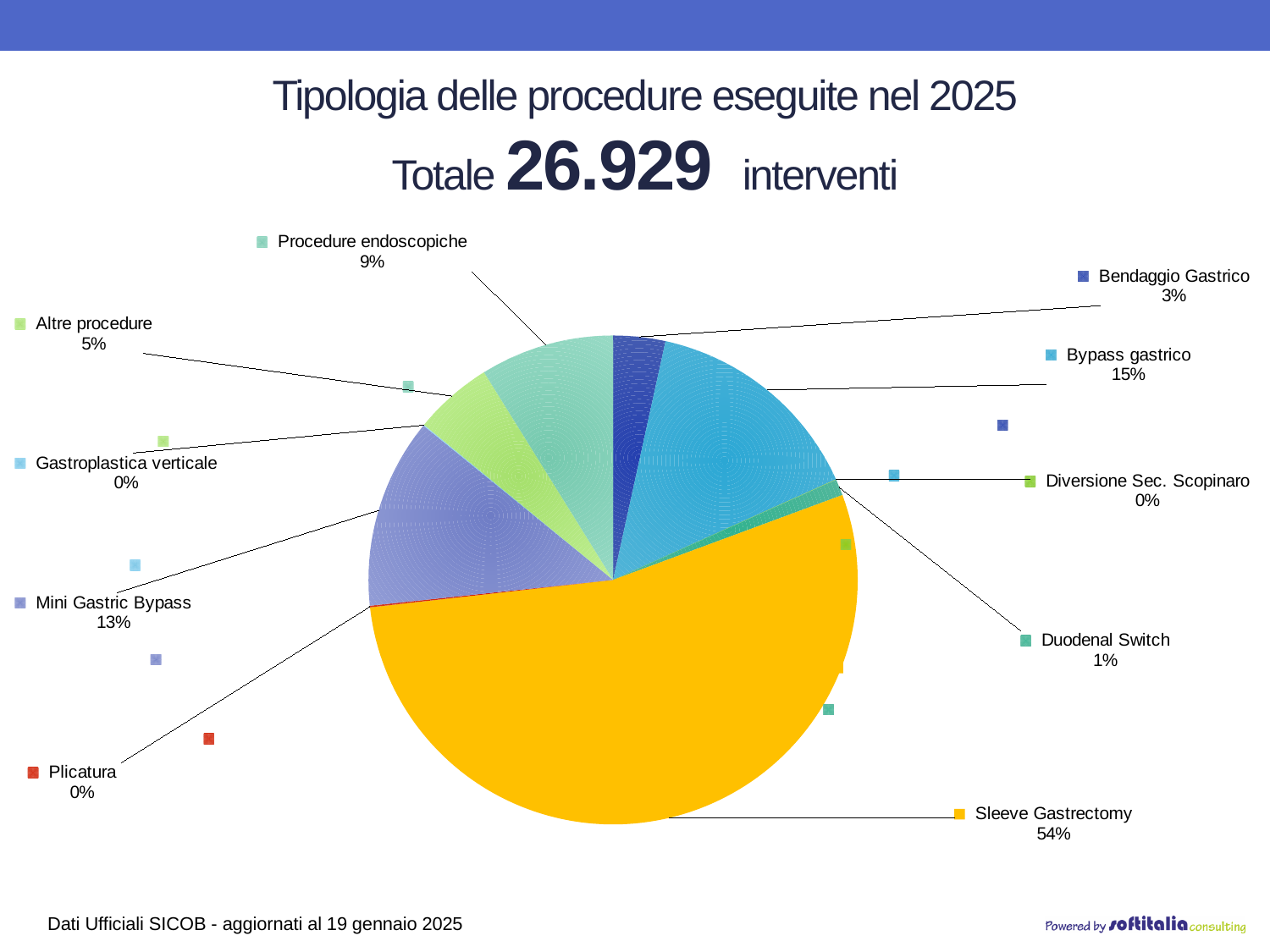
What is the difference in percentage points between Bypass gastrico and Mini Gastric Bypass? 2 Which procedure has the largest slice of the pie? Sleeve Gastrectomy What percentage is shown for Bendaggio Gastrico? 3% How many procedure categories are labelled on the pie chart? 10 Which has a larger share, Altre procedure or Procedure endoscopiche? Procedure endoscopiche What is the title of the chart? Tipologia delle procedure eseguite nel 2025 What is the total number of interventi stated on the slide? 26.929 What percentage is shown for Bypass gastrico? 15% What kind of chart is shown on the slide? pie chart What share of the pie does Sleeve Gastrectomy represent? 54% What percentage is shown for Procedure endoscopiche? 9% What percentage is shown for Mini Gastric Bypass? 13%